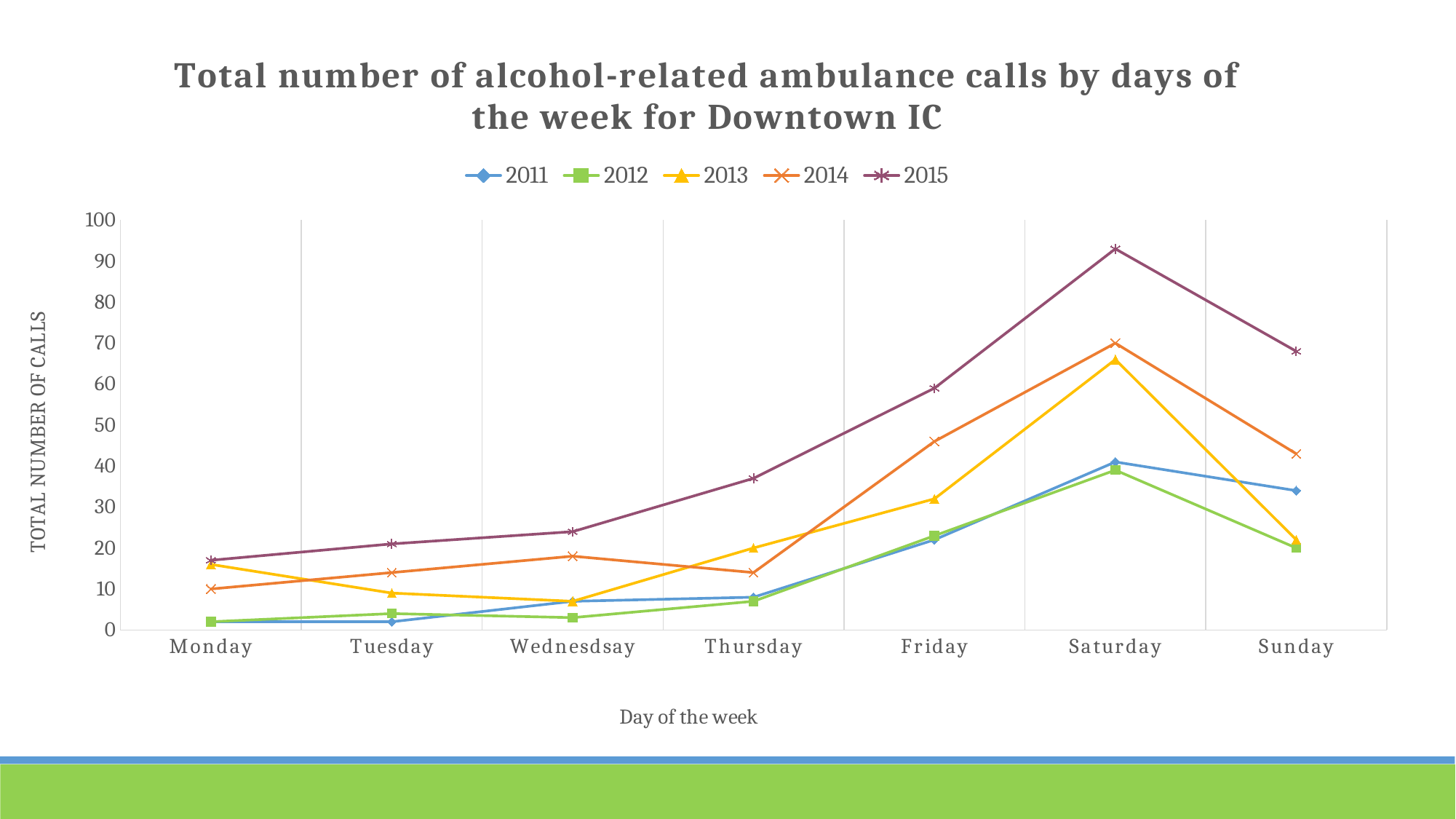
On Saturday, which series has the larger value, 2015 or 2014? 2015 How many series does the legend list? 5 Is the value for 2014 on Friday greater or less than 50? less On which day does the 2015 series reach its highest value? Saturday Is the value for 2013 on Saturday greater or less than 60? greater Is the value for 2015 on Saturday greater or less than 90? greater Does the 2015 series rise or fall from Monday to Saturday? rise How many days of the week are plotted along the x axis? 7 What kind of chart is shown on the slide? line chart On which day does the 2015 series have its lowest value? Monday On Sunday, which series has the larger value, 2011 or 2012? 2011 On which day does the 2014 series reach its highest value? Saturday